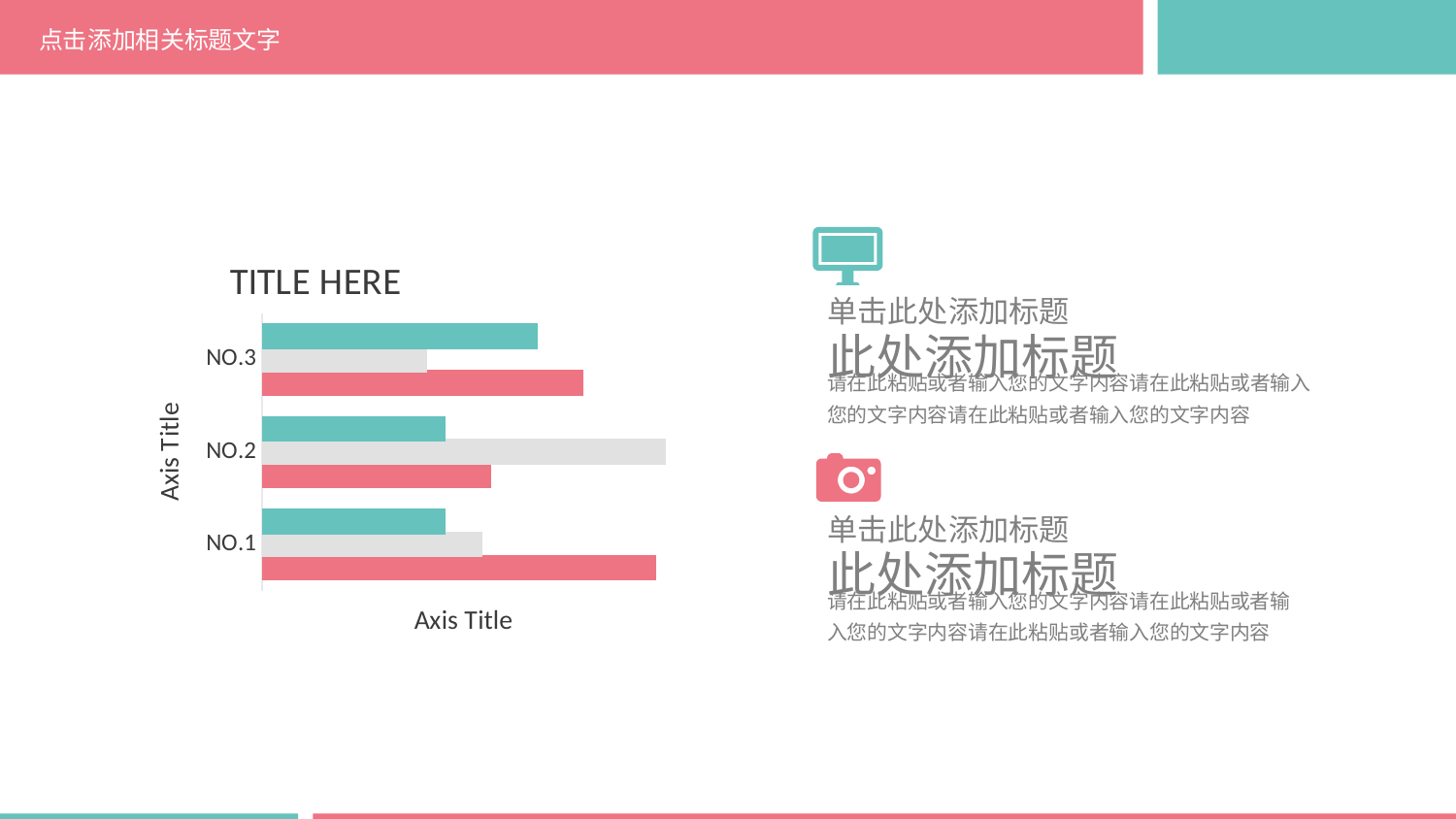
How many categories are shown on the vertical axis of the chart? 3 For category NO.1, which bar is longer: the pink bar or the teal bar? the pink bar For category NO.2, which bar is longer: the grey bar or the teal bar? the grey bar Which category has the longest teal bar? NO.3 Which category has the longest grey bar? NO.2 For category NO.3, which bar is longer: the teal bar or the grey bar? the teal bar What is the label of the horizontal axis of the chart? Axis Title What type of chart is shown on the slide? bar chart Which category has the longest pink bar? NO.1 Which category has the shortest grey bar? NO.3 What is the title of the chart? TITLE HERE How many bars are plotted for each category in the chart? 3